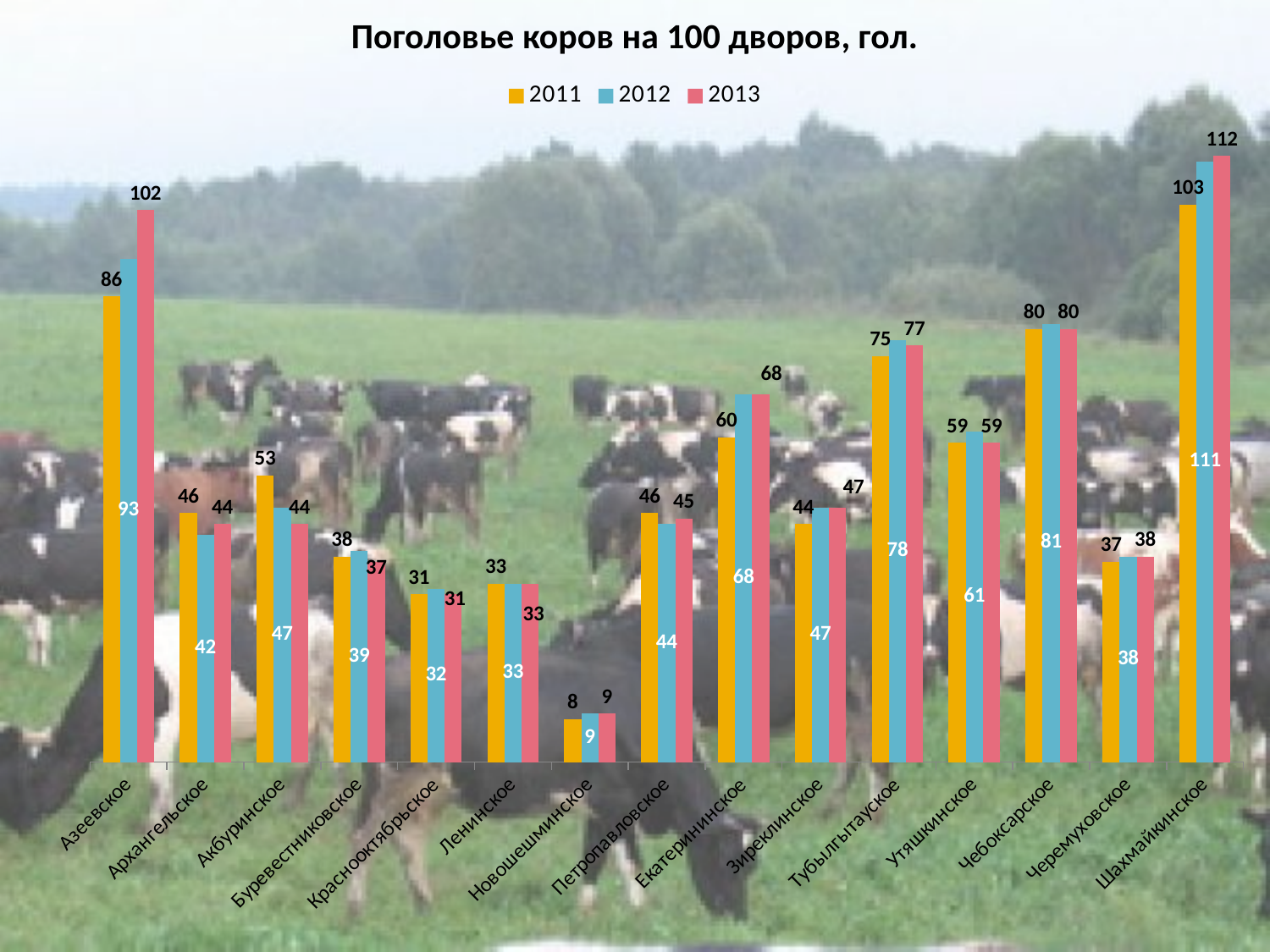
What is the title of the chart? Поголовье коров на 100 дворов, гол. Which is larger: the 2011 value for Акбуринское or the 2011 value for Архангельское? Акбуринское Which category has the lowest value in 2011? Новошешминское What is the value for Шахмайкинское in 2012? 111 Which category has the highest value in 2013? Шахмайкинское What kind of chart is shown on the slide? bar chart What is the difference between the 2013 and 2011 values for Азеевское? 16 What is the value for Екатерининское in 2011? 60 Do the values for Шахмайкинское rise or fall from 2011 to 2013? rise How many categories are shown on the x axis? 15 What is the value for Азеевское in 2013? 102 How many series does the legend list? 3